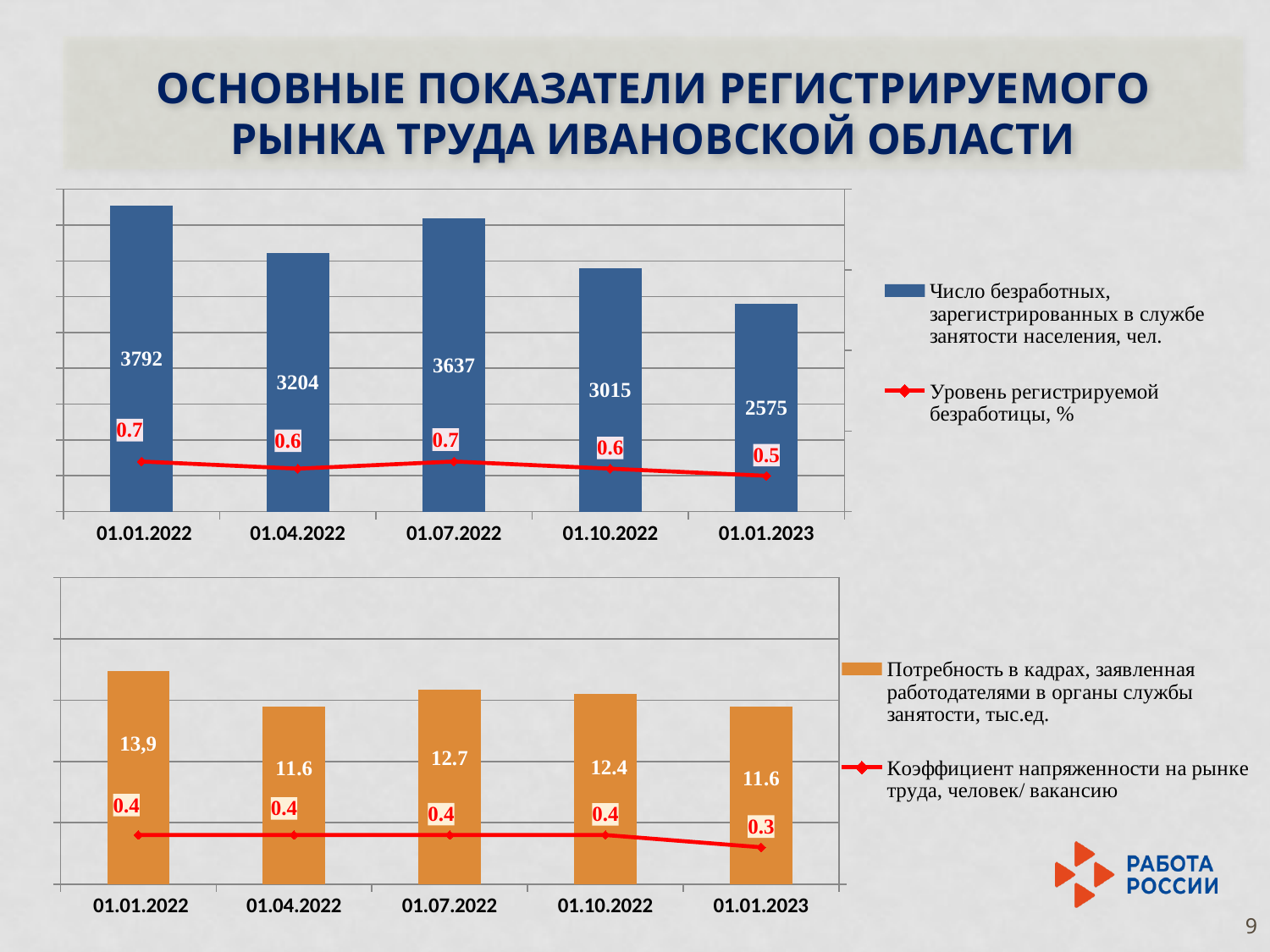
What type of chart is used for the number of registered unemployed in the top chart? Bar chart In the top chart, which is larger: the number of registered unemployed on 01.04.2022 or on 01.07.2022? 01.07.2022 In the bottom chart, on which date is the demand for personnel highest? 01.01.2022 In the bottom chart, what is the demand for personnel (Потребность в кадрах, тыс.ед.) on 01.07.2022? 12.7 In the bottom chart, what is the labour market tension coefficient (Коэффициент напряженности) on 01.01.2023? 0.3 How many series does the legend of the bottom chart list? 2 In the top chart, what is the number of registered unemployed (Число безработных) on 01.01.2022? 3792 In the top chart, on which date is the number of registered unemployed highest? 01.01.2022 In the top chart, what is the difference between the number of registered unemployed on 01.01.2022 and on 01.01.2023? 1217 In the top chart, on which date is the number of registered unemployed lowest? 01.01.2023 In the top chart, what is the registered unemployment rate (Уровень регистрируемой безработицы, %) on 01.01.2023? 0.5 In the top chart, how many dates are shown on the x axis? 5